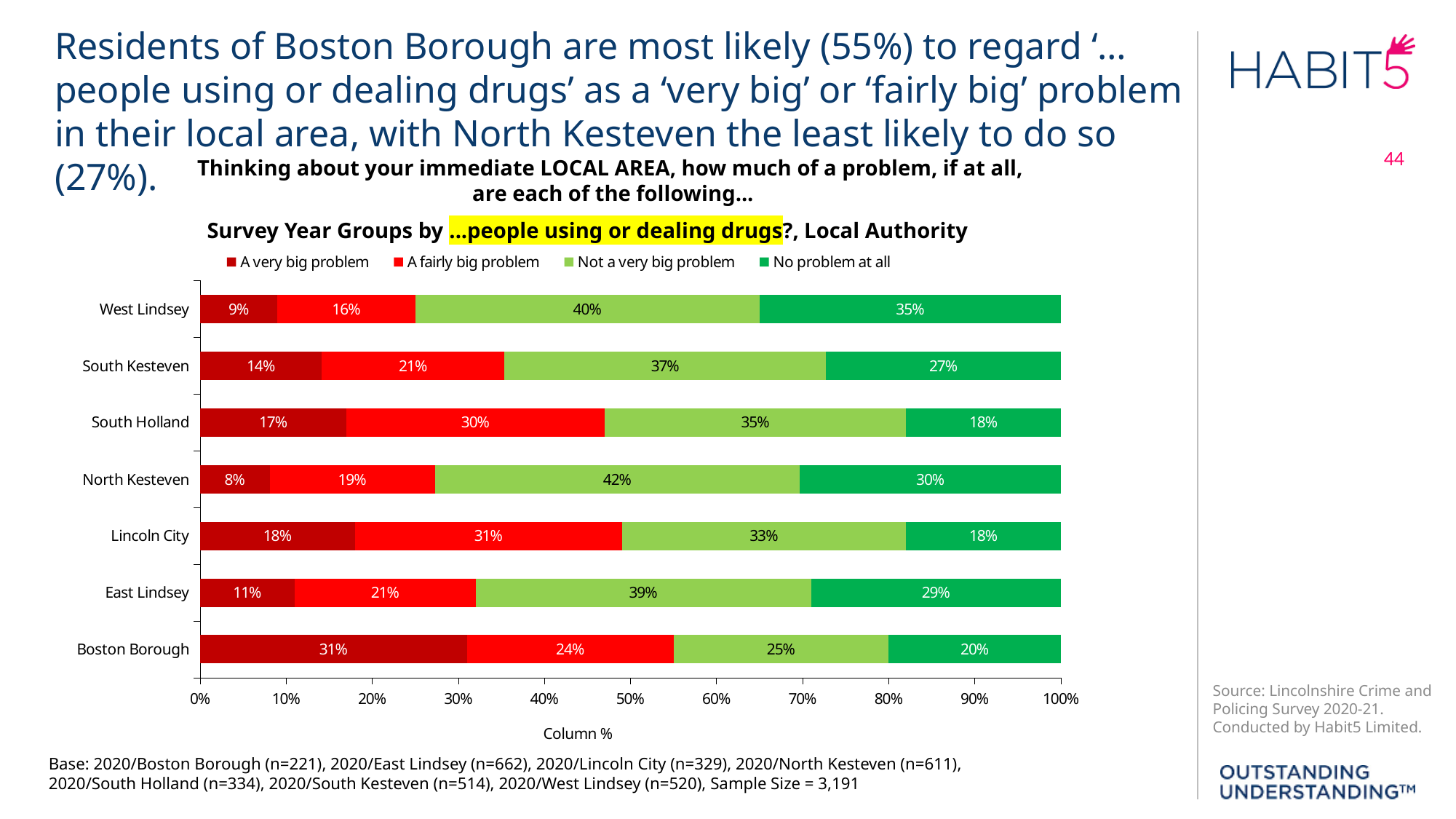
What percentage of North Kesteven residents said 'No problem at all'? 30% What is the combined share of 'A very big problem' and 'A fairly big problem' for Boston Borough? 55% Which is larger: the 'A fairly big problem' share for Lincoln City or for East Lindsey? Lincoln City What kind of chart is shown on the slide? Stacked bar chart Which local authority has the highest share of 'A very big problem' responses? Boston Borough Which local authority has the lowest share of 'A very big problem' responses? North Kesteven What percentage of Boston Borough residents said people using or dealing drugs is 'A very big problem'? 31% Which local authority has the highest share of 'No problem at all' responses? West Lindsey What is the difference between the 'Not a very big problem' share for North Kesteven and for Boston Borough? 17% What percentage of South Holland residents said 'A fairly big problem'? 30% How many series does the legend list? 4 How many local authorities are shown in the chart? 7